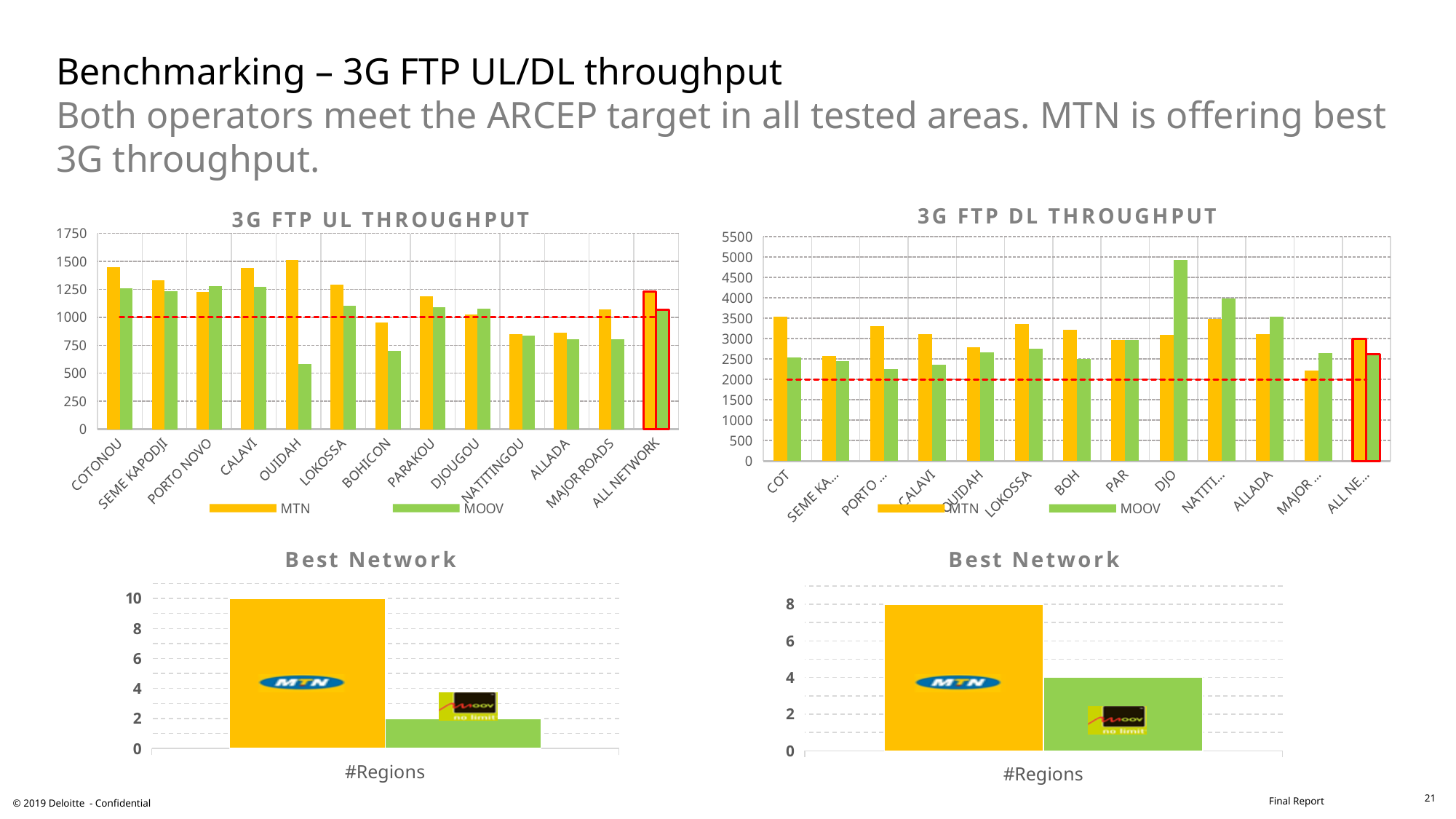
In the 'Best Network' chart on the bottom left, what is the value for MOOV? 2 In the '3G FTP UL THROUGHPUT' chart, is the MOOV value for OUIDAH greater or less than 750? less In the '3G FTP DL THROUGHPUT' chart, is the MOOV value for DJO greater or less than 4500? greater In the '3G FTP DL THROUGHPUT' chart, which category has the highest MOOV value? DJO In the 'Best Network' chart on the bottom right, what is the value for MTN? 8 In the '3G FTP DL THROUGHPUT' chart, how many series does the legend list? 2 In the 'Best Network' chart on the bottom left, what is the value for MTN? 10 In the 'Best Network' chart on the bottom left, what is the difference between the MTN and MOOV values? 8 What kind of chart is the '3G FTP DL THROUGHPUT' chart? bar chart In the 'Best Network' chart on the bottom right, what is the difference between the MTN and MOOV values? 4 In the '3G FTP UL THROUGHPUT' chart, how many categories are shown on the x axis? 13 In the '3G FTP UL THROUGHPUT' chart, which category has the highest MTN value? OUIDAH